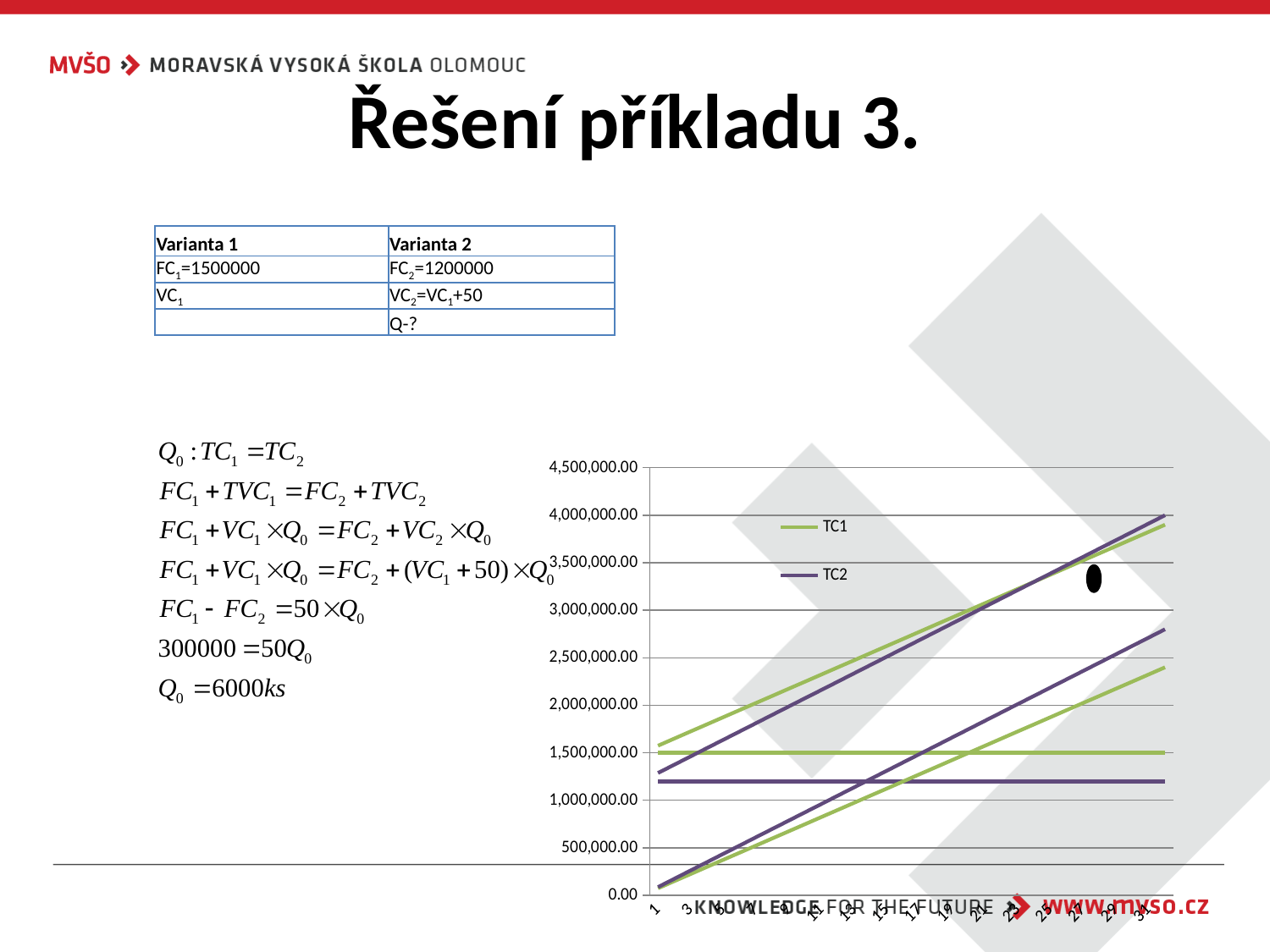
At the left end of the x axis (category 1), is the TC1 line greater or less than 2,000,000.00? less Is the value of the flat purple line in the chart greater or less than 1,000,000.00? greater Does the TC1 line rise or fall as you move along the x axis? rise How many series does the chart legend list? 2 What colour is the TC2 line in the chart? purple At the left end of the x axis (category 1), which line is higher, TC1 or TC2? TC1 At the left end of the x axis (category 1), is the TC2 line greater or less than 1,500,000.00? less What is the highest value shown on the chart's vertical axis? 4,500,000.00 What are the two series named in the chart legend? TC1 and TC2 What kind of chart is shown on the slide? line chart